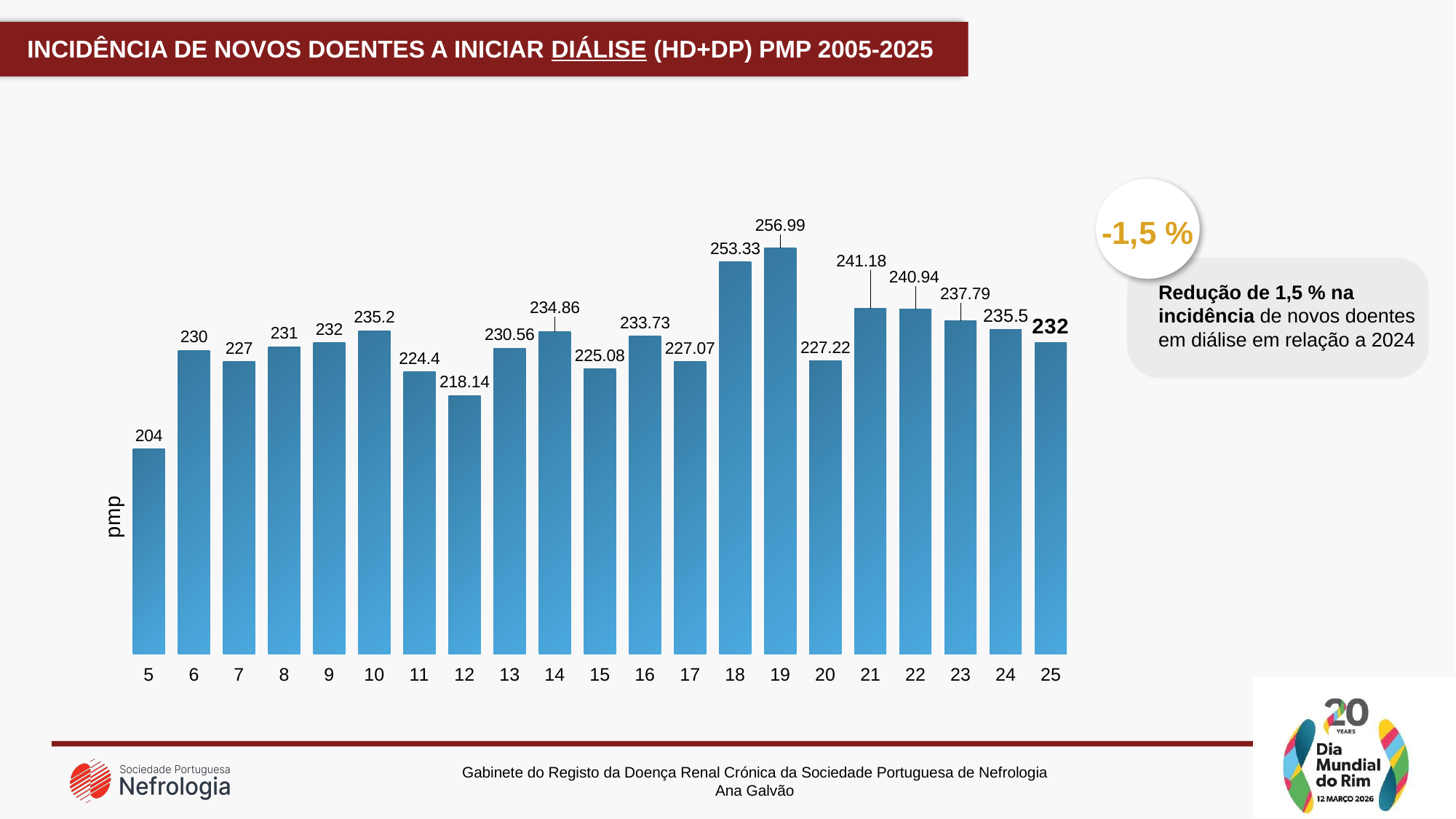
What is the difference between the values for categories 19 and 18? 3.66 What kind of chart is shown on the slide? bar chart What is the value for category 25? 232 Which is larger, the value for category 18 or the value for category 20? 18 What is the difference between the values for categories 24 and 25? 3.5 What is the value for category 5? 204 How many bars are shown in the chart? 21 What is the label on the vertical axis of the chart? pmp What is the value for category 12? 218.14 Which category has the lowest value? 5 Which category has the highest value? 19 What is the value for category 19? 256.99